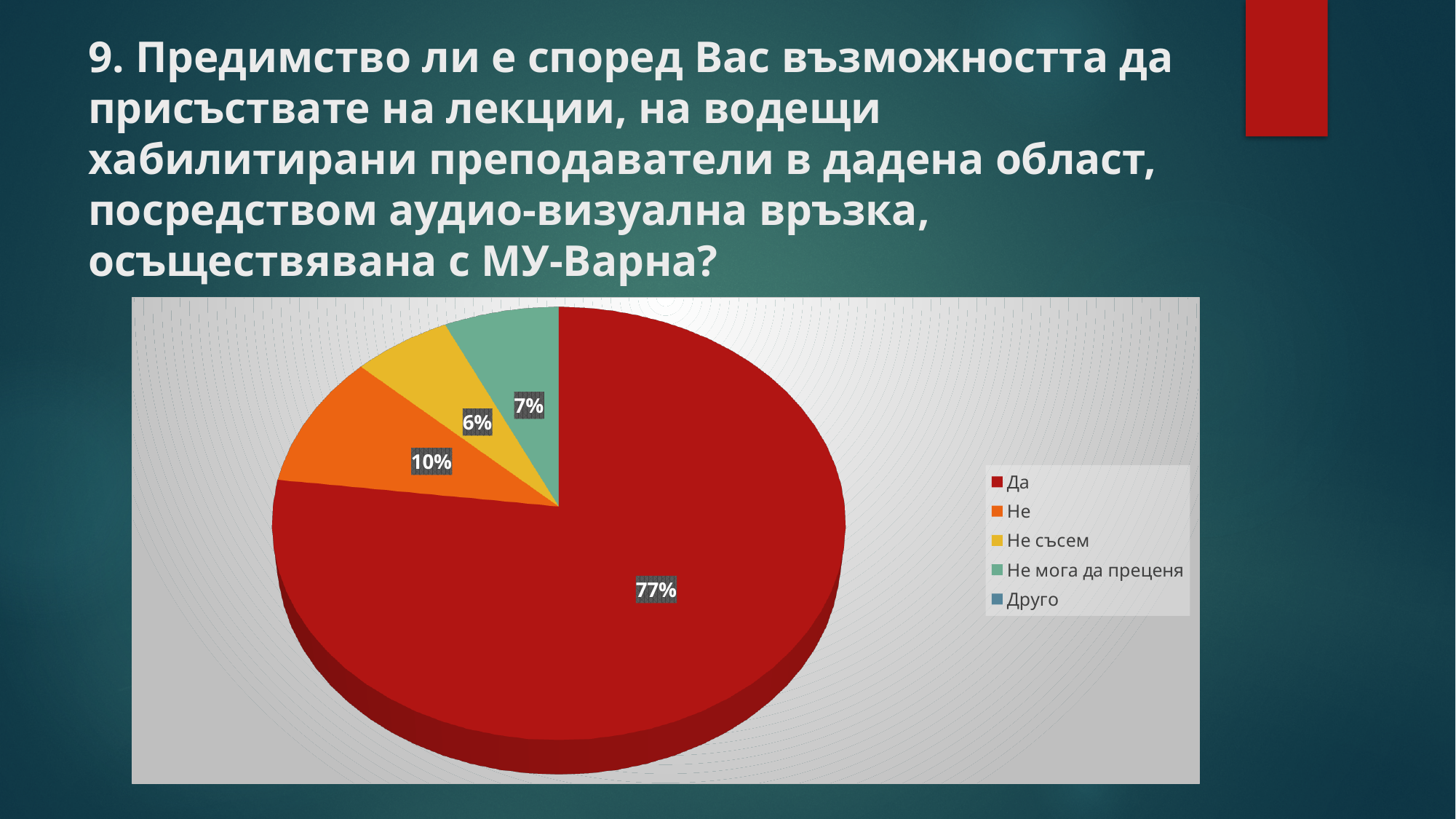
What share of the pie does the "Не" slice represent? 10% Which legend entry has no visible slice in the pie? Друго What share of the pie does the "Да" slice represent? 77% What share of the pie does the "Не съсем" slice represent? 6% How many entries does the legend list? 5 What colour is the "Да" slice? red What kind of chart is shown on the slide? pie chart Which of the labelled slices is the smallest? Не съсем Which slice is larger, "Не мога да преценя" or "Не съсем"? Не мога да преценя What is the difference in percentage points between the "Да" slice and the "Не" slice? 67 Which category has the largest slice of the pie? Да